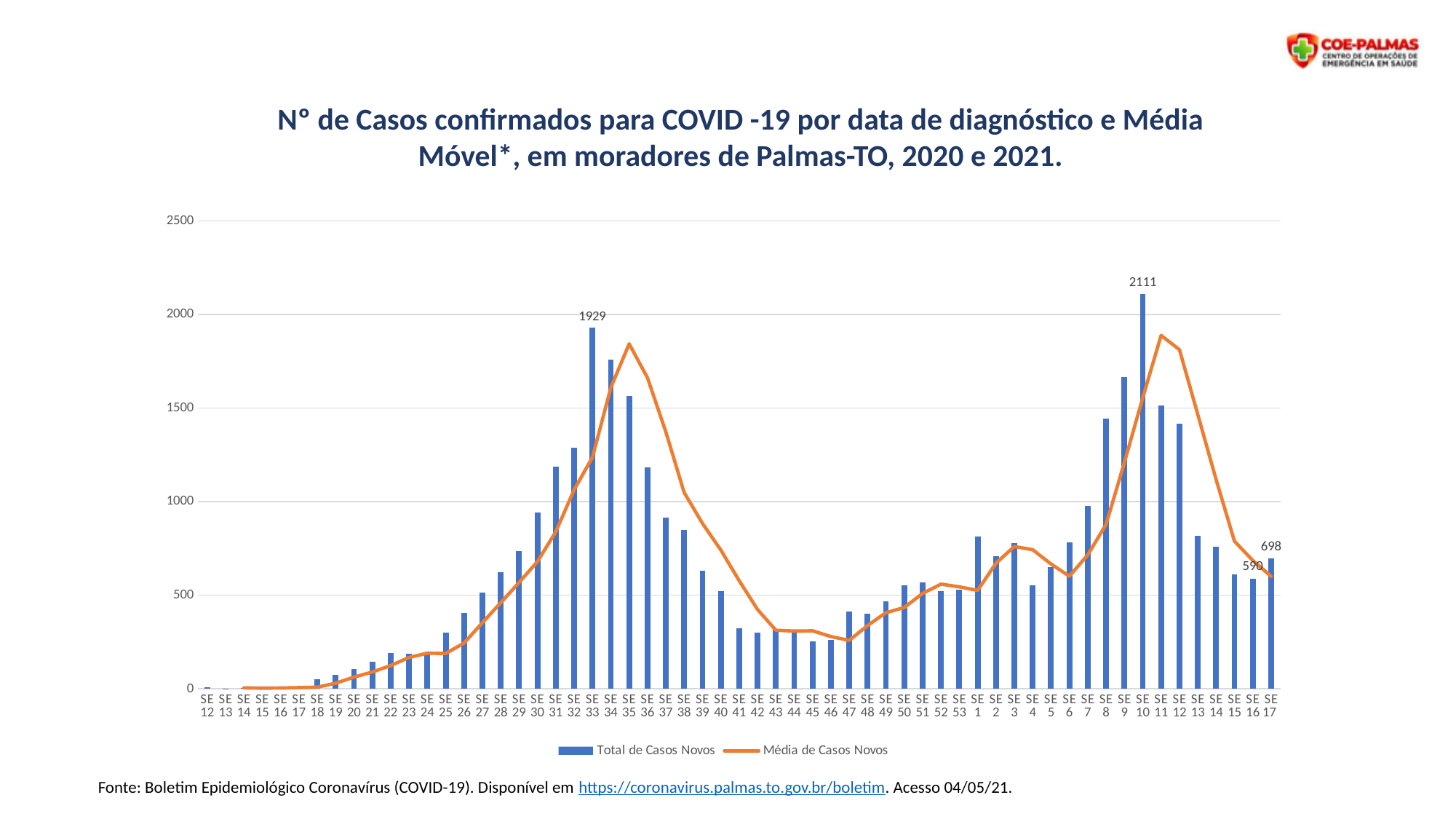
How many series does the legend list? 2 What is the value of Total de Casos Novos for SE 10? 2111 Which epidemiological week (SE) has the highest number of Total de Casos Novos? SE 10 What is the value of Total de Casos Novos for SE 16? 590 What is the difference between the Total de Casos Novos for SE 10 and SE 33? 182 Which is larger, the Total de Casos Novos for SE 33 or for SE 10? SE 10 Is the Total de Casos Novos for SE 9 greater or less than 1500? greater What kind of chart is shown on the slide? Bar chart with a line overlay What is the difference between the Total de Casos Novos for SE 17 and SE 16? 108 What is the value of Total de Casos Novos for SE 33? 1929 What is the value of Total de Casos Novos for SE 17? 698 Is the Total de Casos Novos for SE 30 greater or less than 1000? less